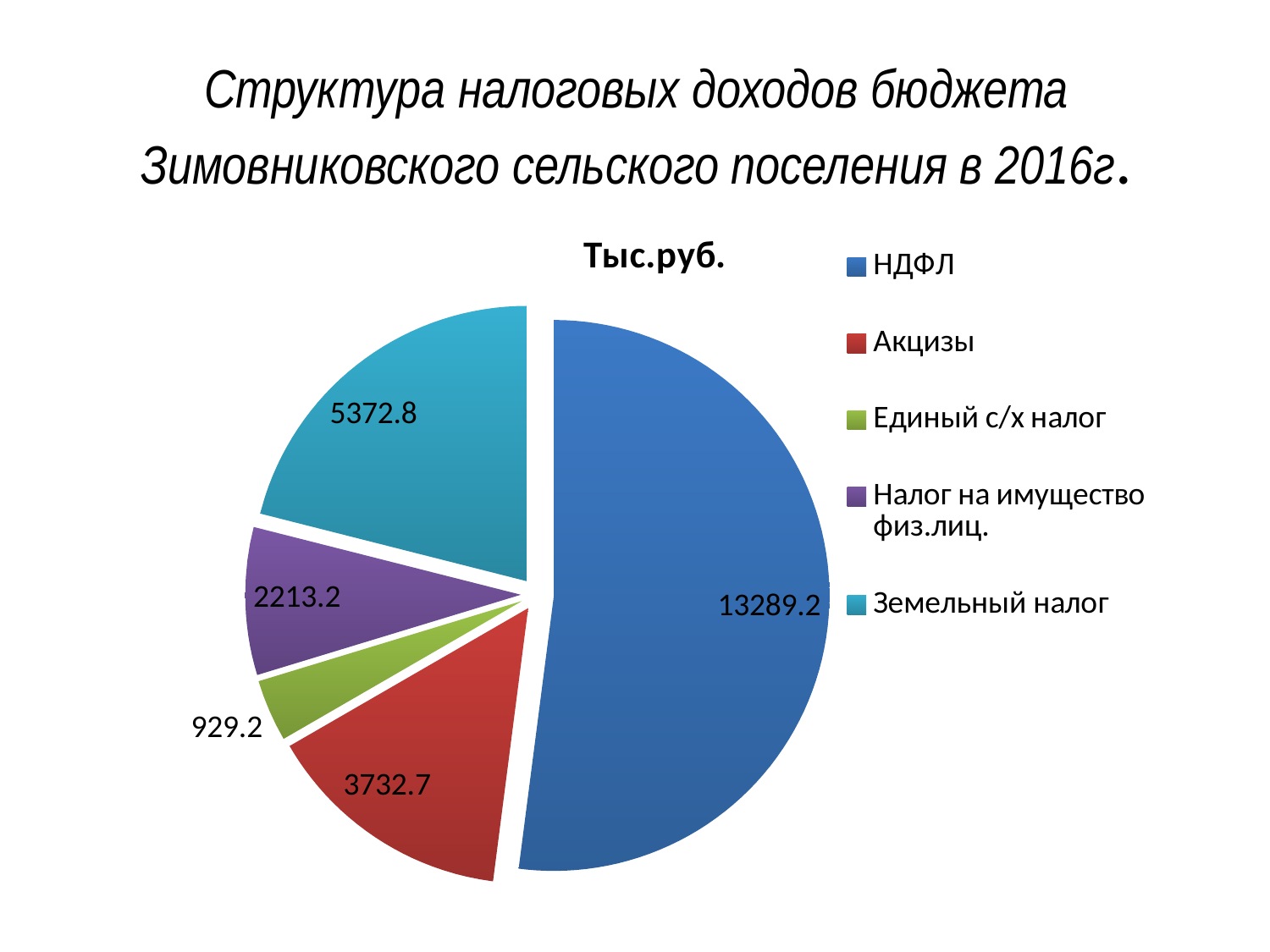
What is the value for Налог на имущество физ.лиц.? 2213.2 What is the difference between the values for Земельный налог and Акцизы? 1640.1 Which category has the largest slice? НДФЛ What is the value for Земельный налог? 5372.8 What is the title shown above the pie chart? Тыс.руб. How many categories does the pie chart have? 5 Which category has the smallest slice? Единый с/х налог What is the value for Акцизы? 3732.7 What is the difference between the values for НДФЛ and Земельный налог? 7916.4 Which is larger, Акцизы or Налог на имущество физ.лиц.? Акцизы What is the value for НДФЛ? 13289.2 What type of chart is shown on the slide? pie chart